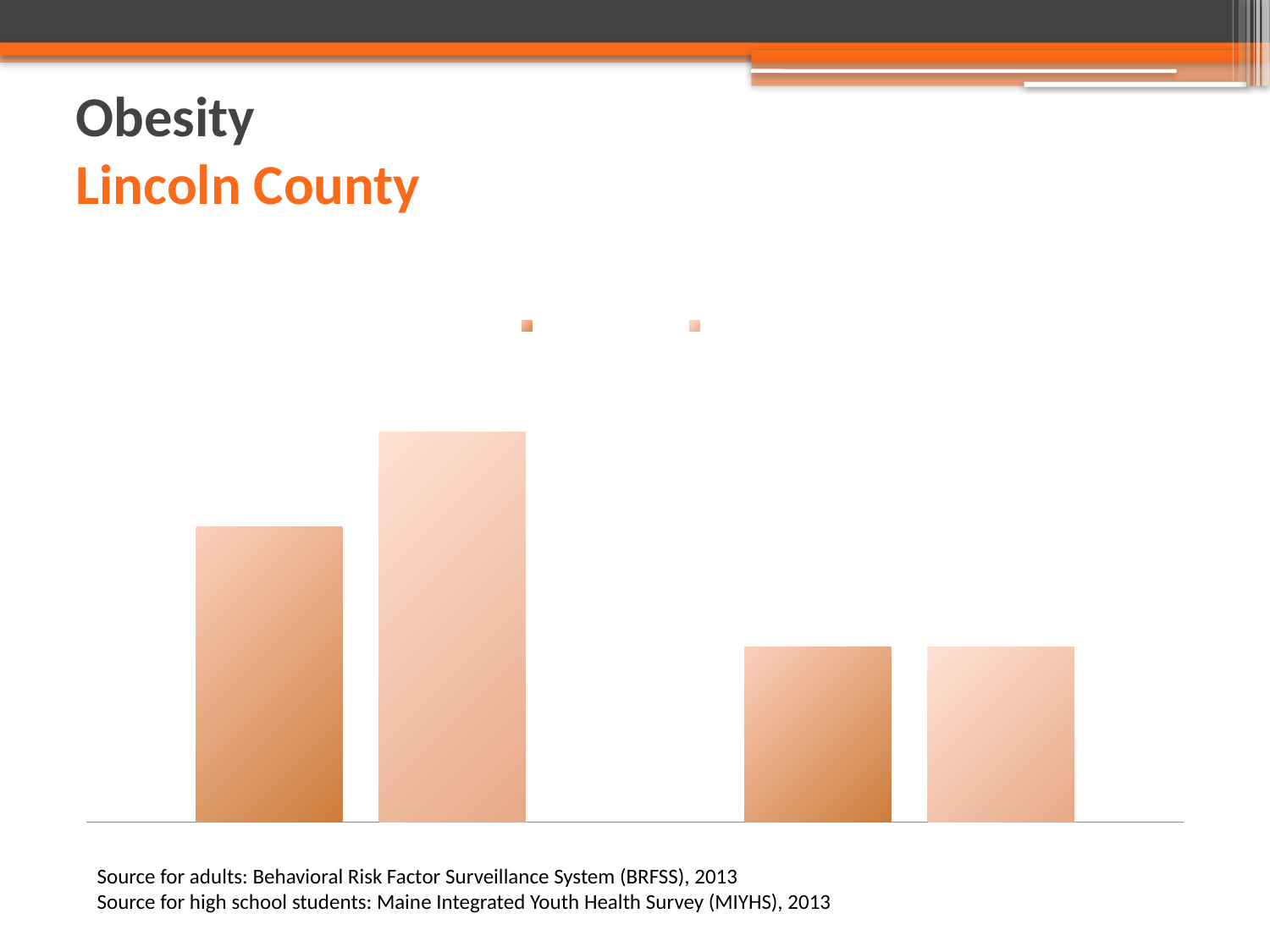
Which bar is the tallest in the chart, counting from the left? the second bar Is the first bar from the left taller or shorter than the second bar from the left? shorter Into how many groups are the bars arranged in the chart? 2 What kind of chart is shown on the slide? bar chart How many bars are plotted in the chart? 4 How many series does the chart's legend show? 2 What is the title of the slide containing the chart? Obesity Lincoln County What year is cited for the data sources below the chart? 2013